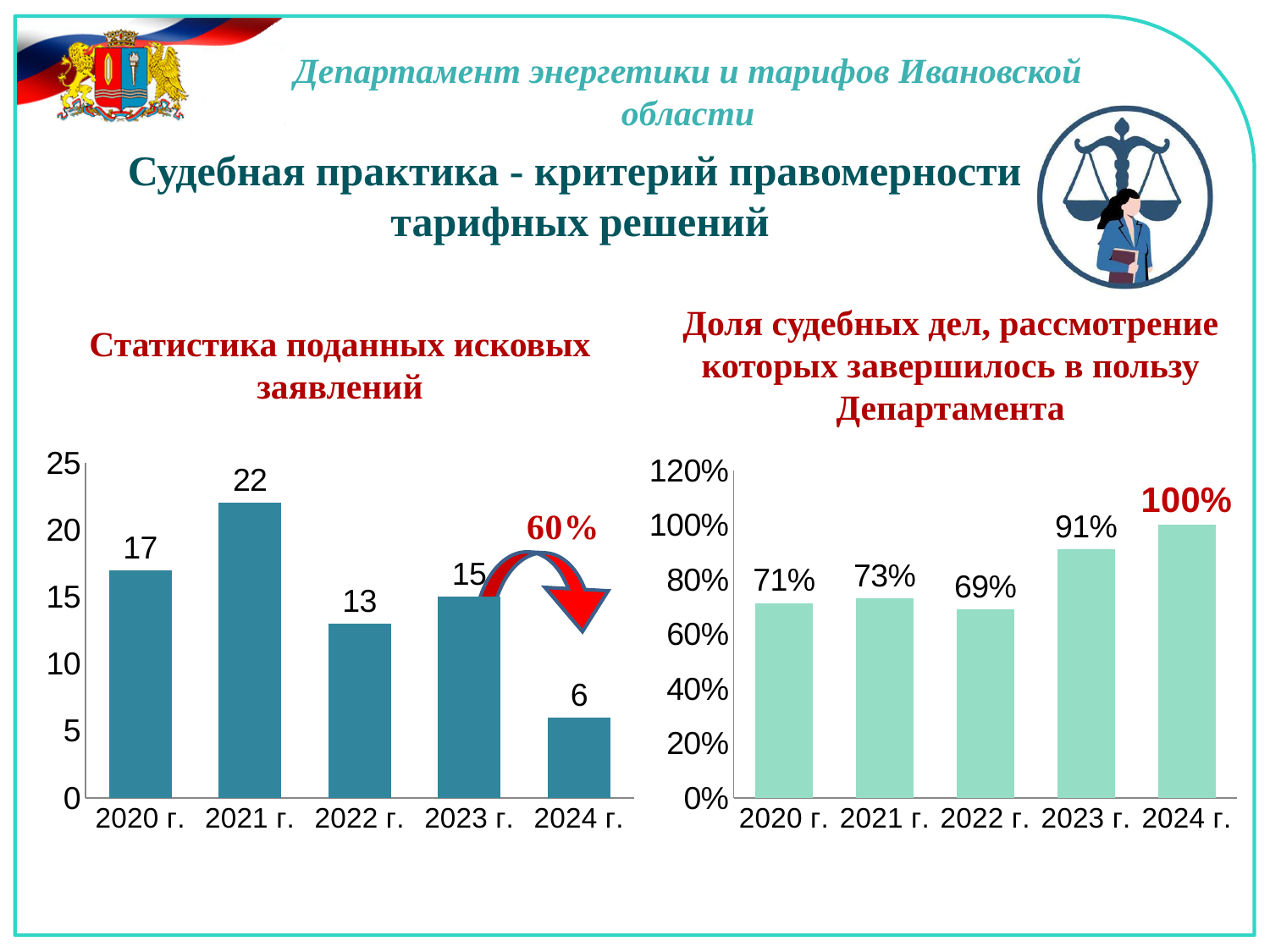
In the right chart (Доля судебных дел, рассмотрение которых завершилось в пользу Департамента), what is the value for 2022 г.? 69% In the right chart (Доля судебных дел, рассмотрение которых завершилось в пользу Департамента), which is larger: the value for 2020 г. or 2023 г.? 2023 г. In the left chart (Статистика поданных исковых заявлений), which year has the lowest value? 2024 г. In the left chart (Статистика поданных исковых заявлений), what is the value for 2024 г.? 6 In the left chart (Статистика поданных исковых заявлений), how many years are shown on the x axis? 5 In the right chart (Доля судебных дел, рассмотрение которых завершилось в пользу Департамента), which year has the lowest value? 2022 г. In the left chart (Статистика поданных исковых заявлений), which year has the highest value? 2021 г. In the right chart (Доля судебных дел, рассмотрение которых завершилось в пользу Департамента), what is the value for 2024 г.? 100% In the right chart (Доля судебных дел, рассмотрение которых завершилось в пользу Департамента), what is the difference between the values for 2023 г. and 2022 г.? 22% In the left chart (Статистика поданных исковых заявлений), what is the value for 2021 г.? 22 What type of chart is the right chart (Доля судебных дел, рассмотрение которых завершилось в пользу Департамента)? Bar chart In the left chart (Статистика поданных исковых заявлений), what is the difference between the values for 2023 г. and 2024 г.? 9